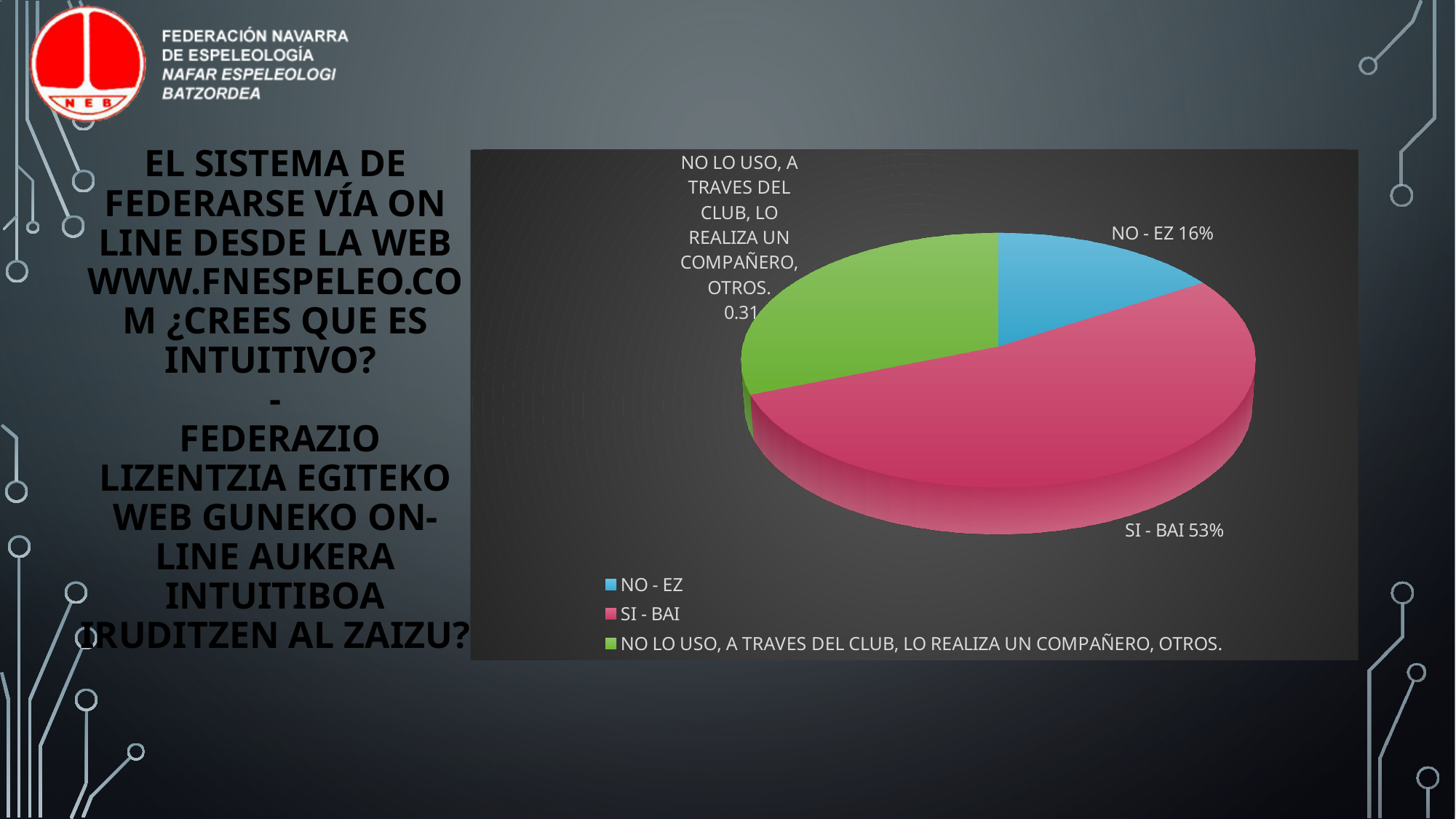
What value is printed on the label for the slice 'NO LO USO, A TRAVES DEL CLUB, LO REALIZA UN COMPAÑERO, OTROS.'? 0.31 What colour is the SI - BAI slice in the pie chart? pink How many entries does the legend list? 3 What kind of chart is shown on the slide? pie chart What is the difference in percentage points between the SI - BAI slice and the NO - EZ slice? 37 Which slice of the pie is the smallest? NO - EZ What colour is the NO - EZ slice in the pie chart? blue Which slice of the pie is the largest? SI - BAI Which is larger, the SI - BAI slice or the NO - EZ slice? SI - BAI How many slices does the pie chart have? 3 What share of the pie does the SI - BAI slice represent? 53% What share of the pie does the NO - EZ slice represent? 16%